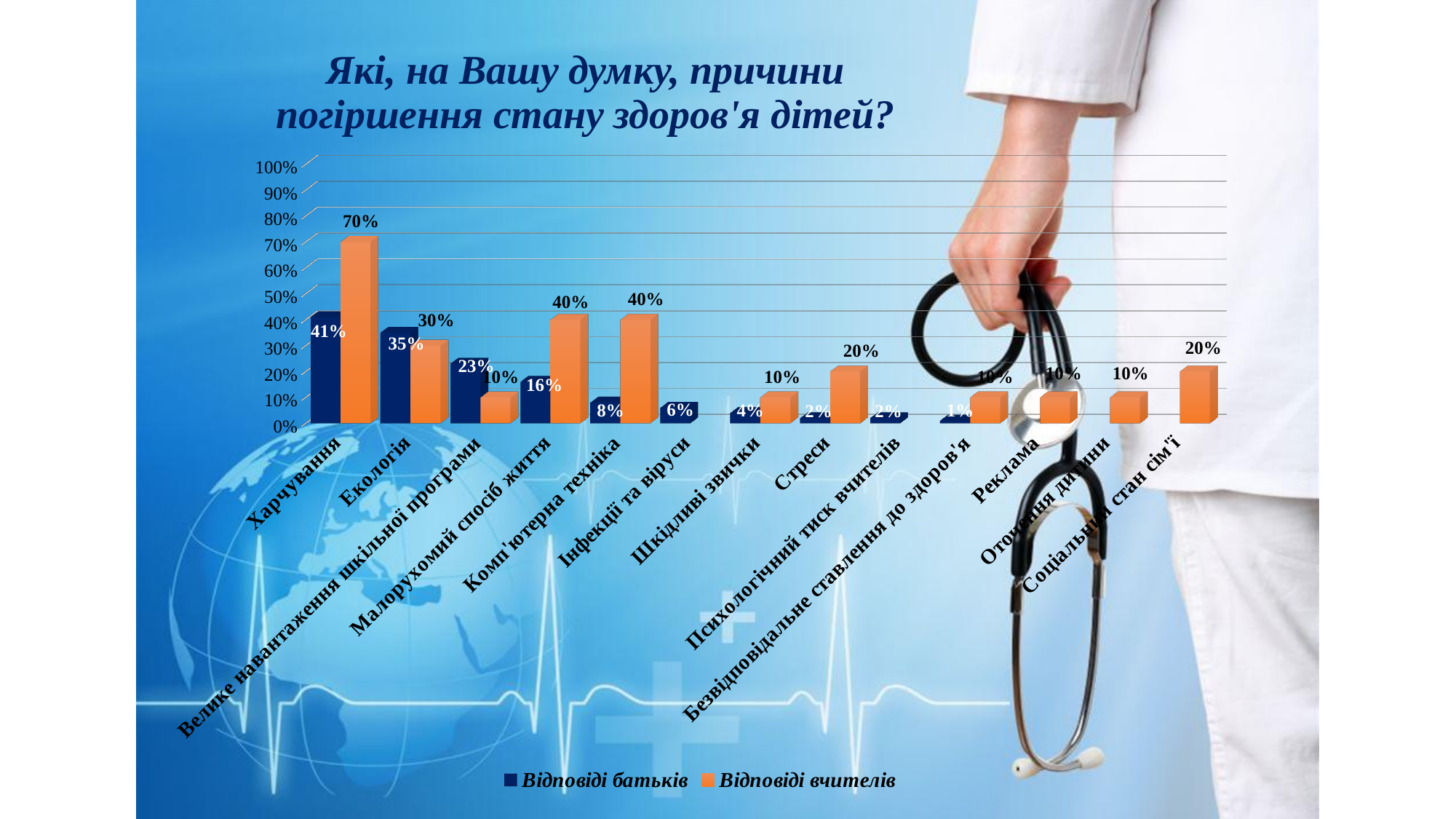
What is the value for Екологія in the Відповіді батьків series? 35% What is the value for Харчування in the Відповіді вчителів series? 70% What is the difference between the Відповіді вчителів and Відповіді батьків values for Малорухомий спосіб життя? 24% What are the two legend entries of the chart? Відповіді батьків, Відповіді вчителів Which category has the lowest value in the Відповіді батьків series? Безвідповідальне ставлення до здоров'я What type of chart is shown on the slide? bar chart What is the value for Харчування in the Відповіді батьків series? 41% How many series does the legend list? 2 What is the difference between the Відповіді вчителів and Відповіді батьків values for Харчування? 29% Which category has the highest value in the Відповіді вчителів series? Харчування For Екологія, which series has the larger value: Відповіді батьків or Відповіді вчителів? Відповіді батьків What is the value for Стреси in the Відповіді вчителів series? 20%